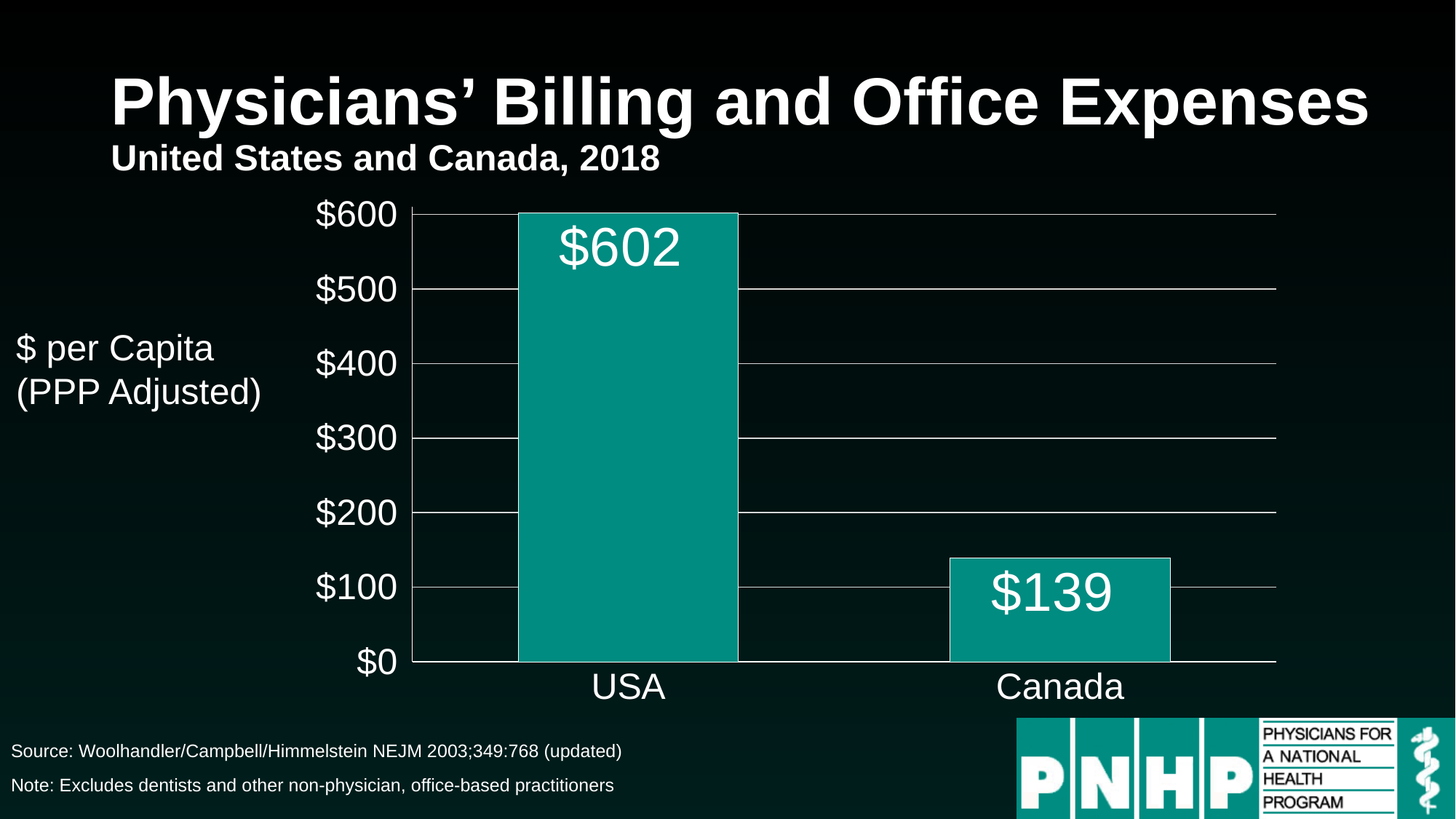
What is the value for USA? $602 What is the value for Canada? $139 How many countries are shown in the chart? 2 Is the value for Canada greater or less than $200? less What is the title of the chart? Physicians' Billing and Office Expenses Which is larger, the value for USA or the value for Canada? USA Which country has the lowest physicians' billing and office expenses per capita? Canada What kind of chart is shown on the slide? bar chart Which country has the highest physicians' billing and office expenses per capita? USA What is the label of the vertical axis? $ per Capita (PPP Adjusted) What is the difference between the USA and Canada values? $463 Is the value for USA greater or less than $500? greater